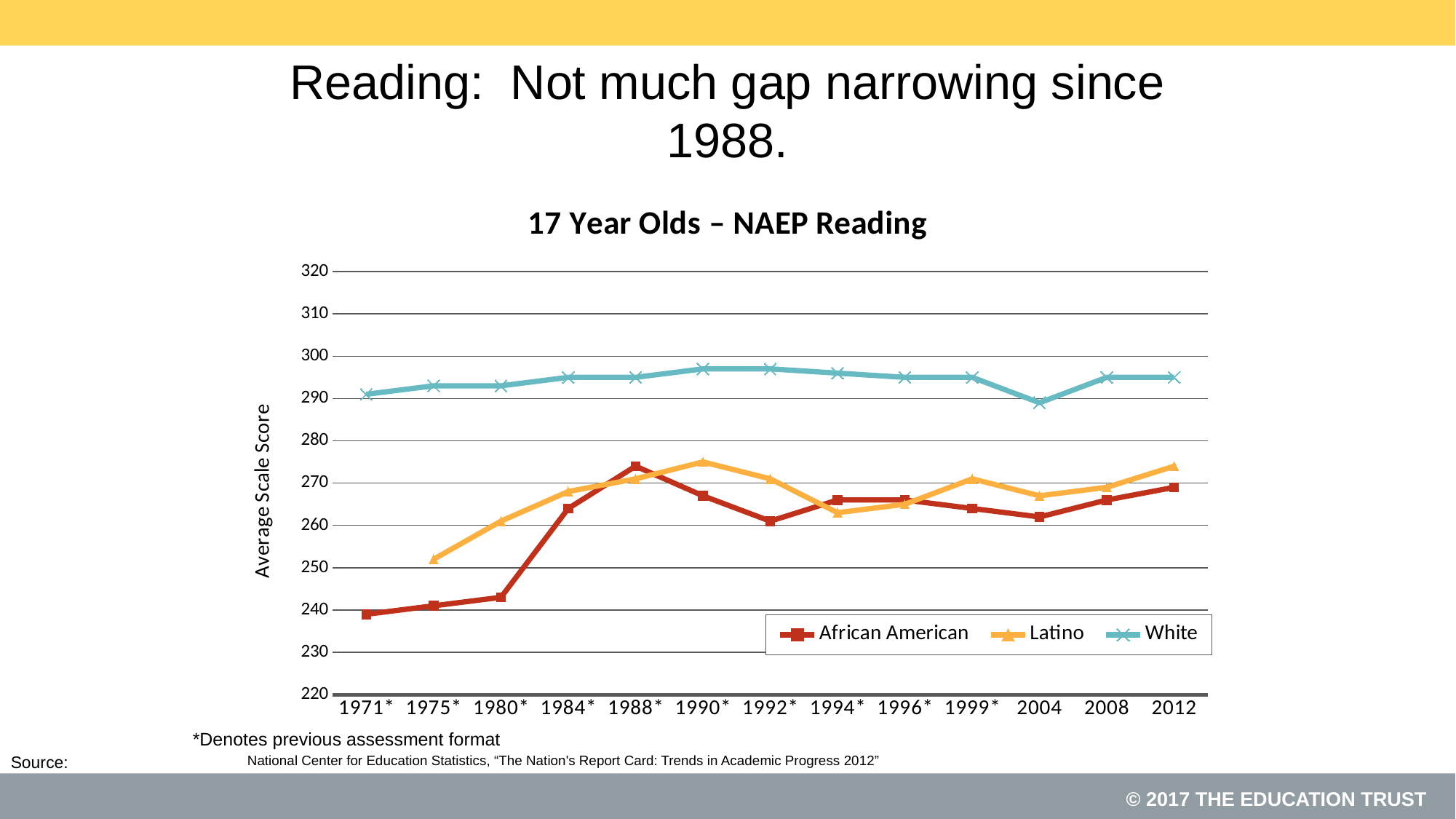
Is the value for African American in 1980* greater or less than 250? less How many assessment years are shown on the x axis? 13 Is the value for African American in 1988* greater or less than 270? greater How many series does the legend list? 3 What is the title of the chart? 17 Year Olds – NAEP Reading What kind of chart is shown on the slide? Line chart Is the value for Latino in 1994* greater or less than 270? less What is the label on the vertical axis? Average Scale Score Does the African American series rise or fall from 1971* to 1988*? Rise In which year does the African American series reach its highest value? 1988* In 2012, which is higher, the Latino value or the African American value? Latino